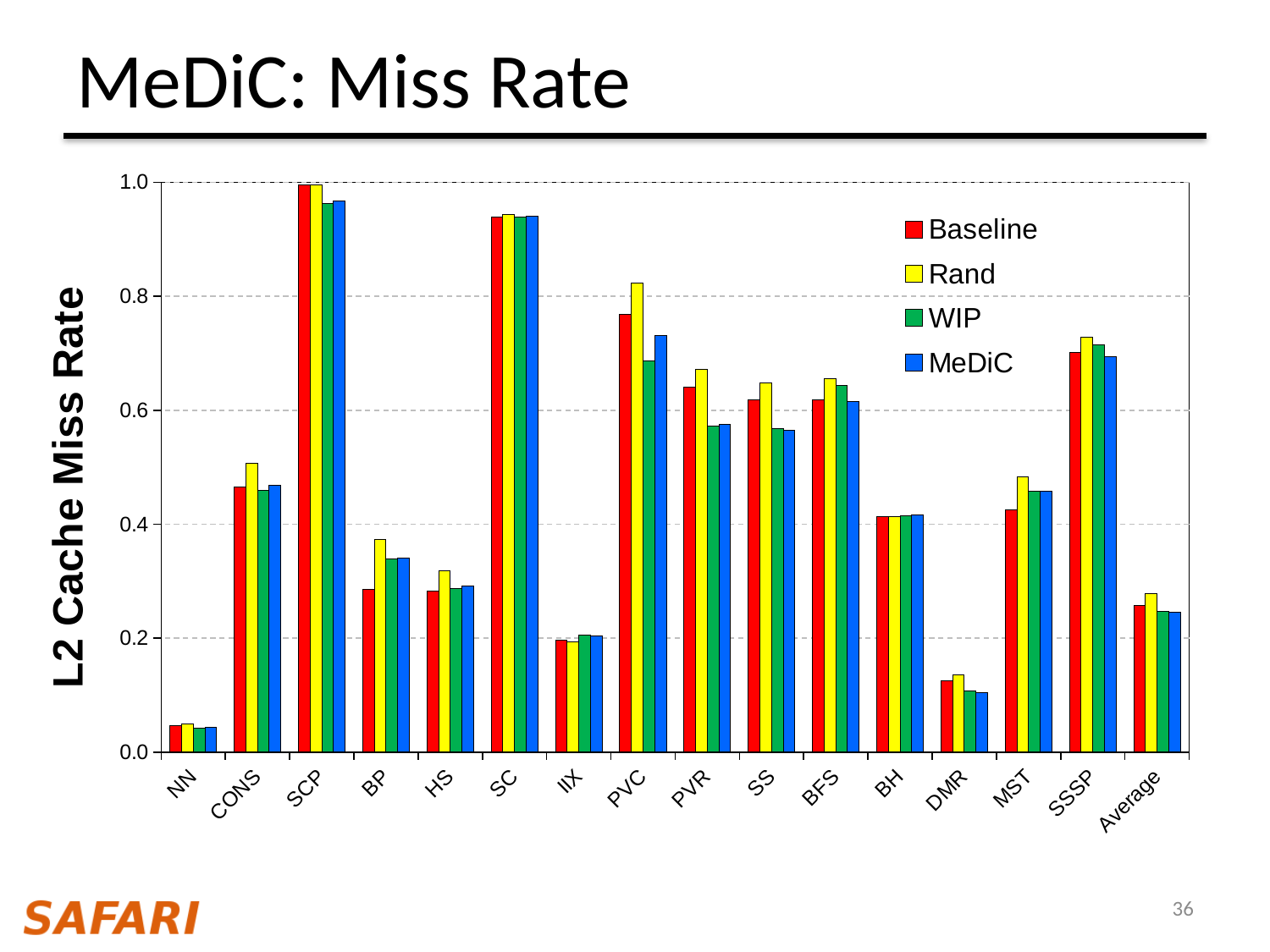
How many categories are shown along the x axis? 16 Which category has the lowest L2 cache miss rate for the Baseline series? NN Is the MeDiC value for Average greater or less than 0.4? less For the Rand series, which is larger: the value for CONS or the value for HS? CONS Is the Baseline value for PVC greater or less than 0.6? greater Which category has the highest L2 cache miss rate for the Baseline series? SCP Is the MeDiC value for DMR greater or less than 0.2? less What is the title of the y axis? L2 Cache Miss Rate What kind of chart is shown on the slide? bar chart How many series does the legend list? 4 For PVC, which is larger: the Rand value or the Baseline value? Rand